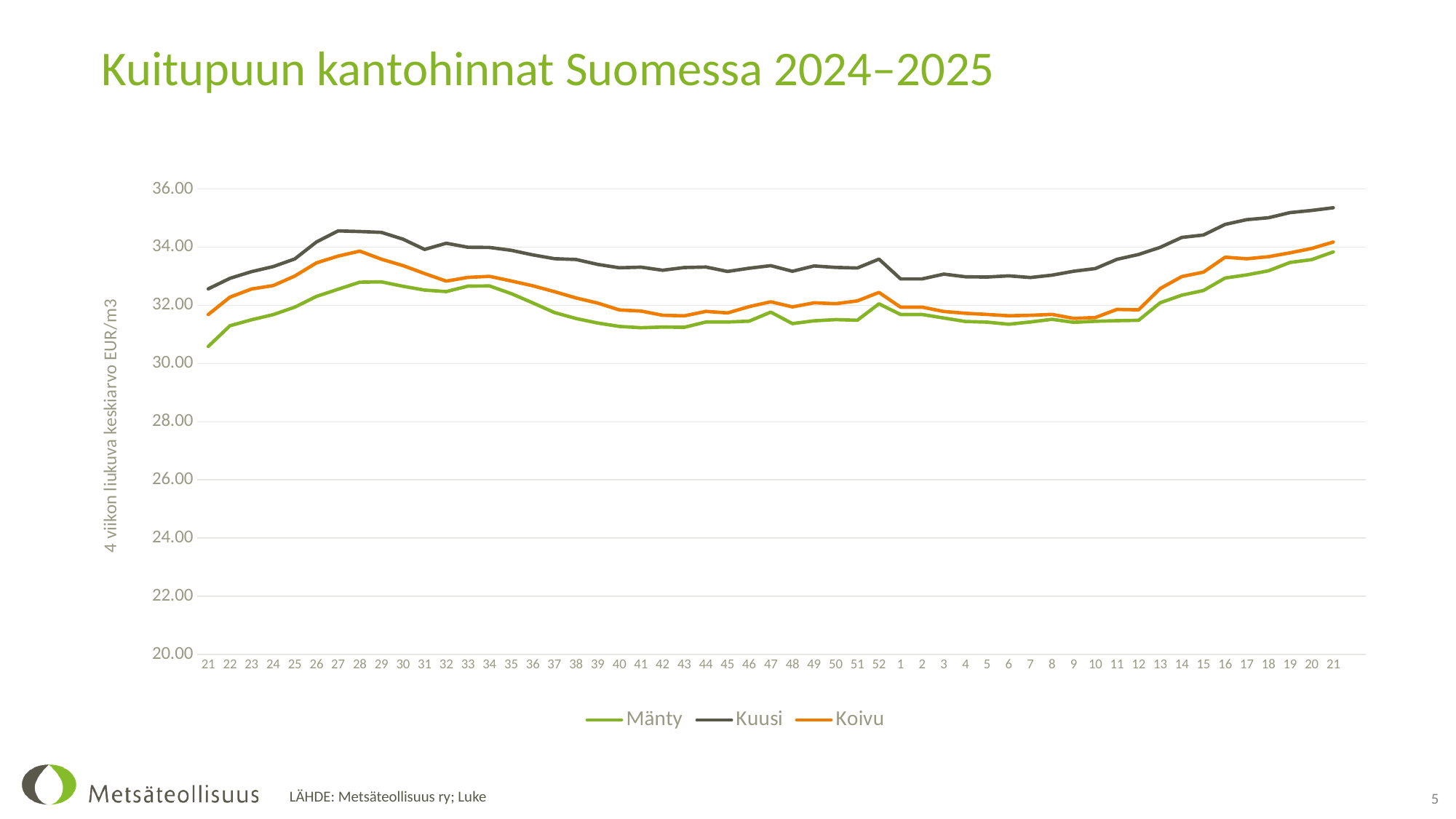
Which series has the highest values across the whole chart? Kuusi At week 27, which series has the higher value, Kuusi or Mänty? Kuusi Is the value for Koivu at week 28 greater or less than 32.00? greater Does the Kuusi line rise or fall from week 12 to week 21 at the right end of the chart? rise What kind of chart is shown on the slide? line chart Is the value for Mänty at the first week 21 (far left) greater or less than 32.00? less How many week points are plotted along the x axis? 53 How many series does the legend list? 3 Is the value for Kuusi at the last week 21 (far right) greater or less than 34.00? greater Which series are listed in the legend? Mänty, Kuusi, Koivu What is the title of the chart? Kuitupuun kantohinnat Suomessa 2024–2025